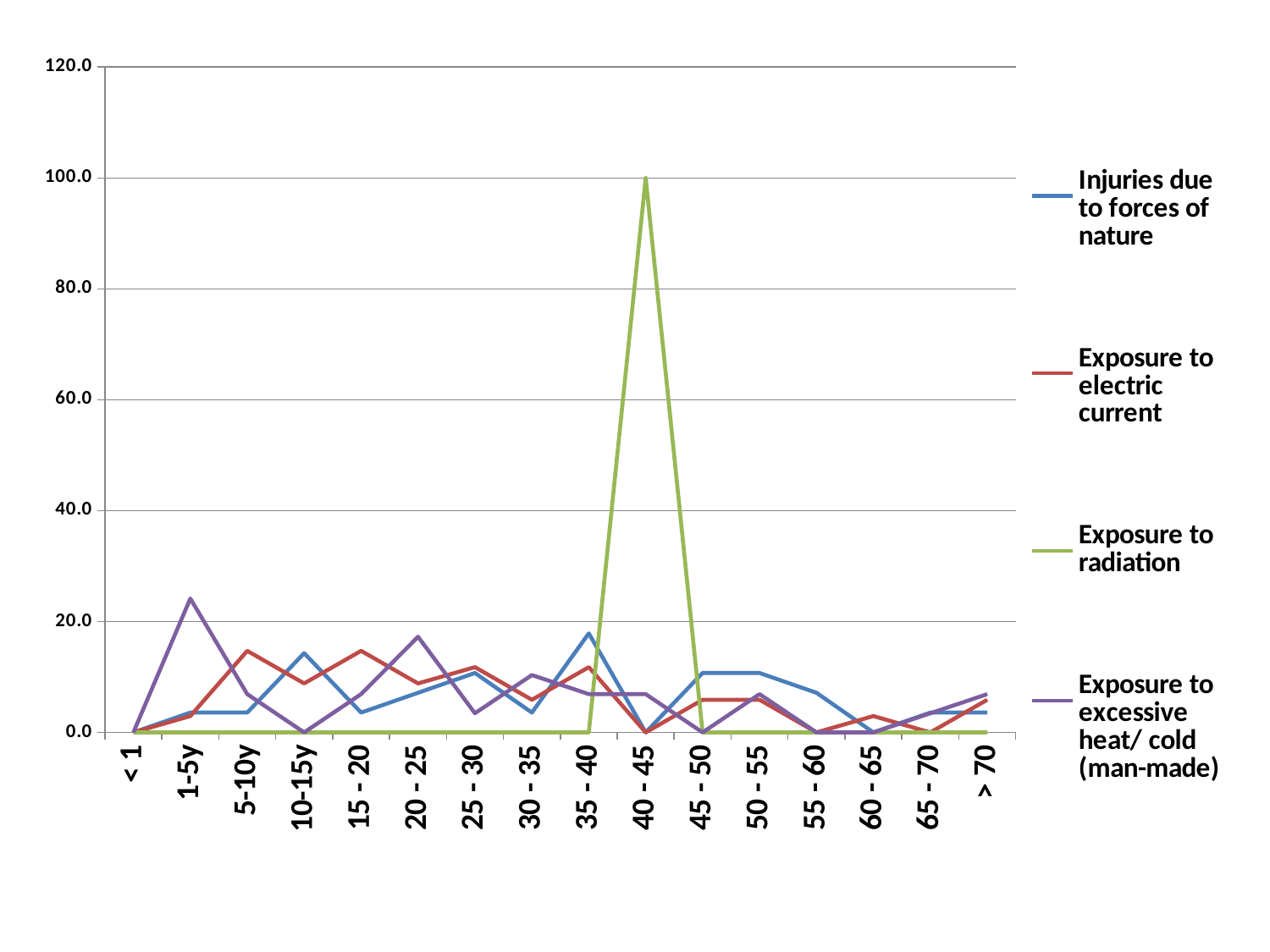
Which series reaches the highest value anywhere on the chart? Exposure to radiation What colour is the line for Exposure to radiation? green What is the value for Exposure to radiation in the < 1 age group? 0.0 How many series does the legend list? 4 How many age-group categories are shown on the x axis? 16 Is the value for Exposure to excessive heat/ cold (man-made) in the 1-5y age group greater or less than 20.0? greater In the 40 - 45 age group, which is larger: Exposure to radiation or Exposure to electric current? Exposure to radiation In which age group does Exposure to radiation reach its highest value? 40 - 45 Is the value for Injuries due to forces of nature in the 35 - 40 age group greater or less than 10.0? greater What is the value for Exposure to radiation in the 40 - 45 age group? 100.0 Is the value for Exposure to electric current in the 5-10y age group greater or less than 10.0? greater What kind of chart is shown on the slide? line chart